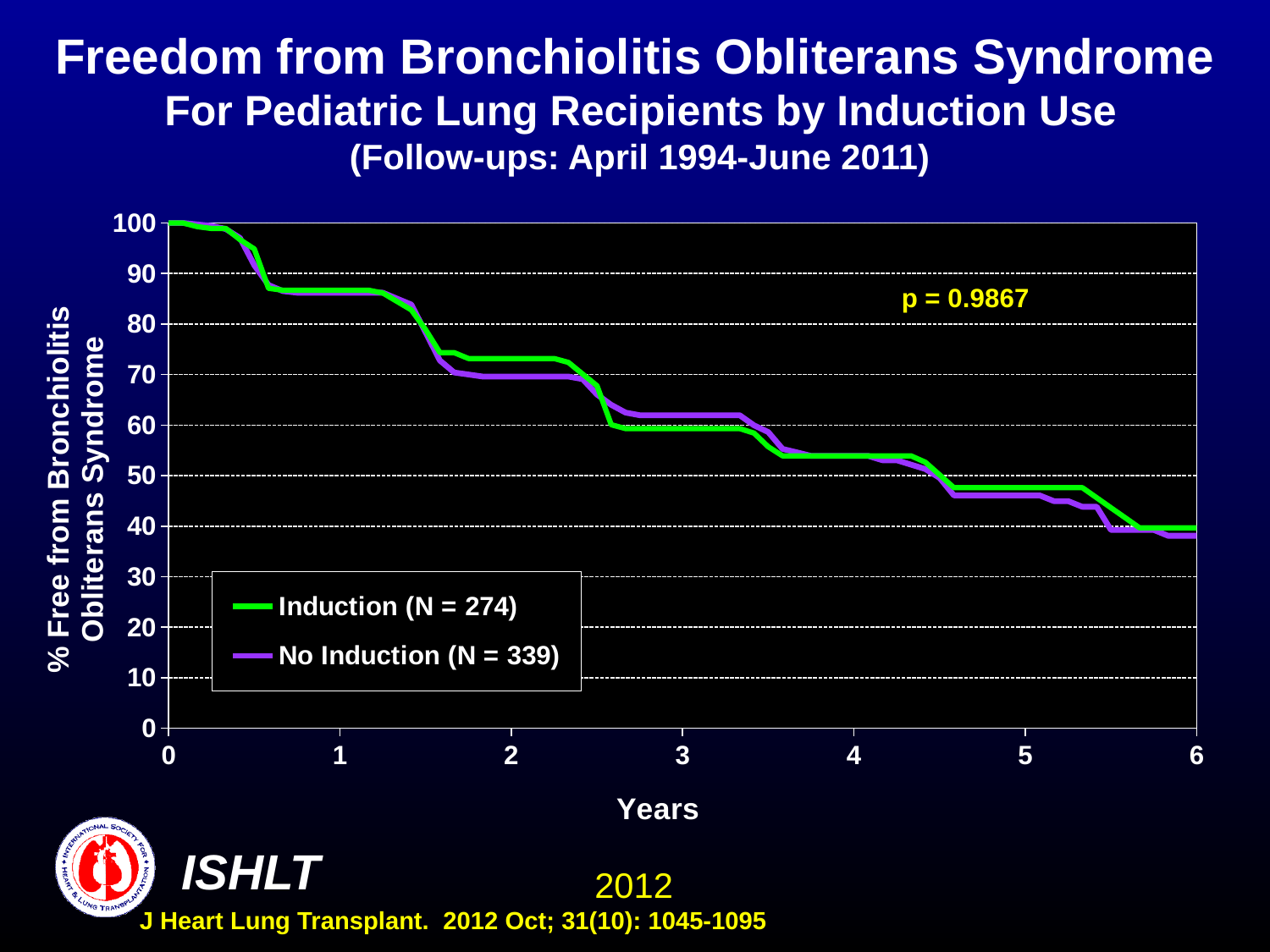
Is the value for No Induction at year 6 greater or less than 50? less Is the value for No Induction at year 5 greater or less than 40? greater Is the value for Induction at year 3 greater or less than 70? less What is the N for the Induction group shown in the legend? 274 What kind of chart is shown on the slide? line chart Do the values for the Induction series rise or fall as years increase? fall Do the values for the No Induction series rise or fall along the x axis? fall How many series does the legend list? 2 What p-value is printed on the chart? p = 0.9867